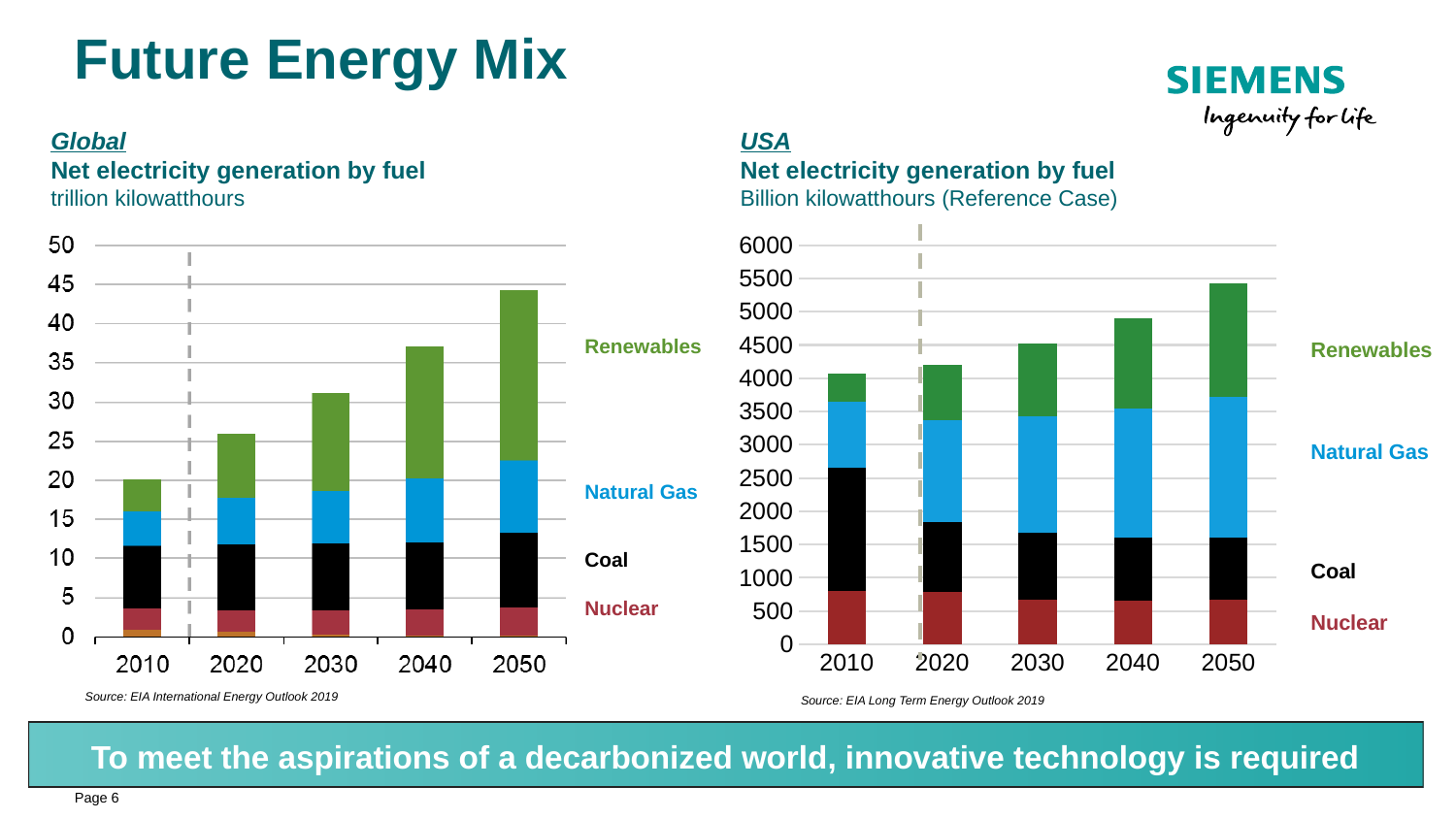
How many fuel categories are labelled on the USA net electricity generation by fuel chart? 4 On the USA chart, does total net electricity generation rise or fall from 2010 to 2050? rise What unit is used on the Global net electricity generation by fuel chart? trillion kilowatthours On the Global chart, is the total bar for 2050 greater or less than 40 trillion kilowatthours? greater On the Global chart, which year has the highest total net electricity generation? 2050 On the Global chart, which year has the lowest total net electricity generation? 2010 On the USA chart, which year has the lowest total net electricity generation? 2010 On the Global chart, is the total bar for 2010 greater or less than 25 trillion kilowatthours? less How many years are shown on the x axis of the USA net electricity generation by fuel chart? 5 On the USA chart, which year has the highest total net electricity generation? 2050 What kind of chart is the Global net electricity generation by fuel chart? stacked bar chart On the USA chart, is the total bar for 2050 greater or less than 5000 billion kilowatthours? greater